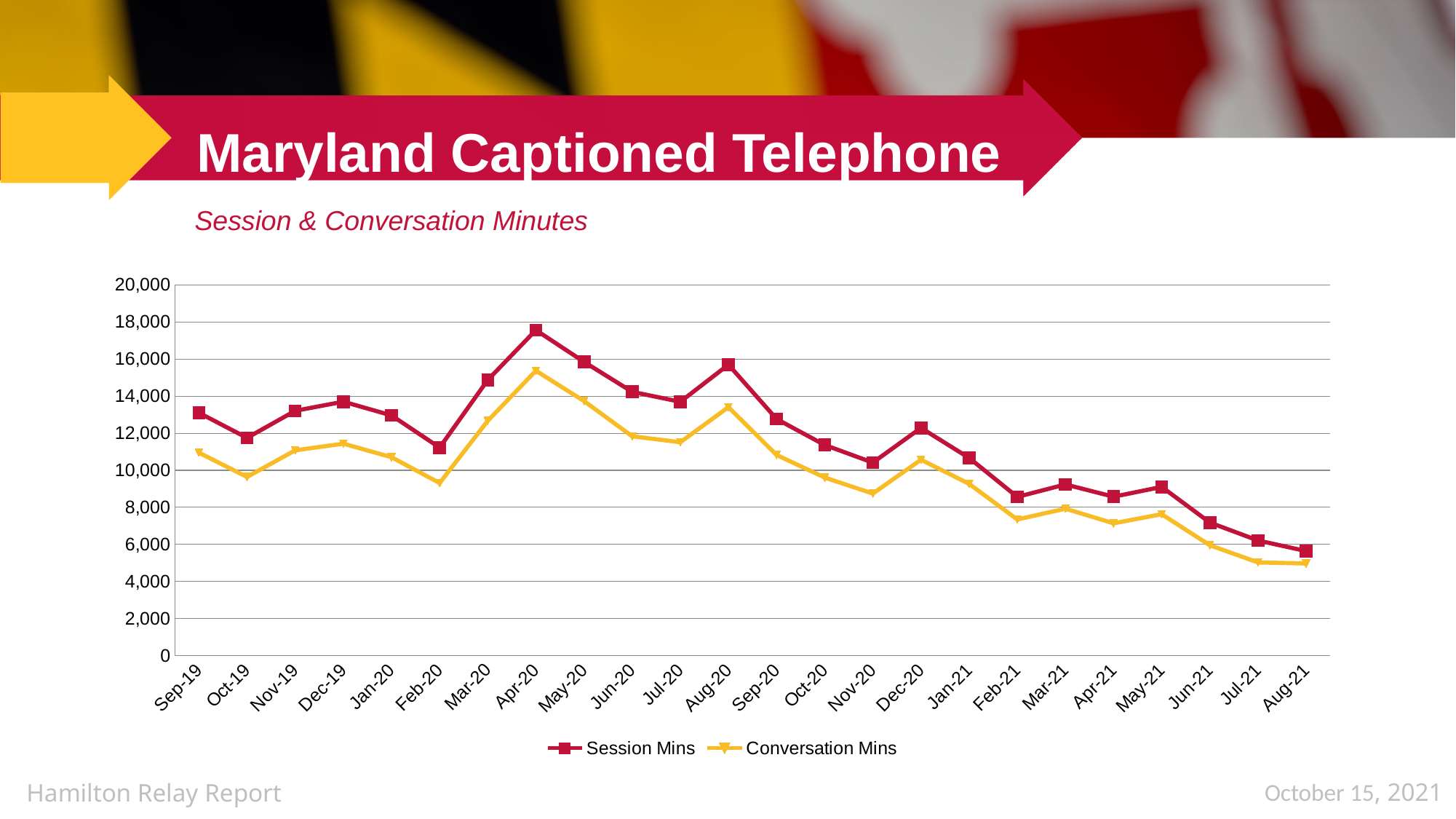
In which month do Session Mins reach their lowest value? Aug-21 In which month do Session Mins reach their highest value? Apr-20 How many months are plotted along the x axis? 24 Which is larger: Session Mins in Apr-20 or Session Mins in Aug-20? Apr-20 Is the value for Conversation Mins in Feb-20 greater or less than 10,000? less Is the value for Session Mins in Apr-20 greater or less than 16,000? greater What is the subtitle shown above the chart? Session & Conversation Minutes What kind of chart is shown on the slide? Line chart Is the value for Session Mins in Aug-21 greater or less than 8,000? less In which month do Conversation Mins reach their highest value? Apr-20 Overall, do Session Mins rise or fall from Sep-19 to Aug-21? Fall How many series does the legend list? 2